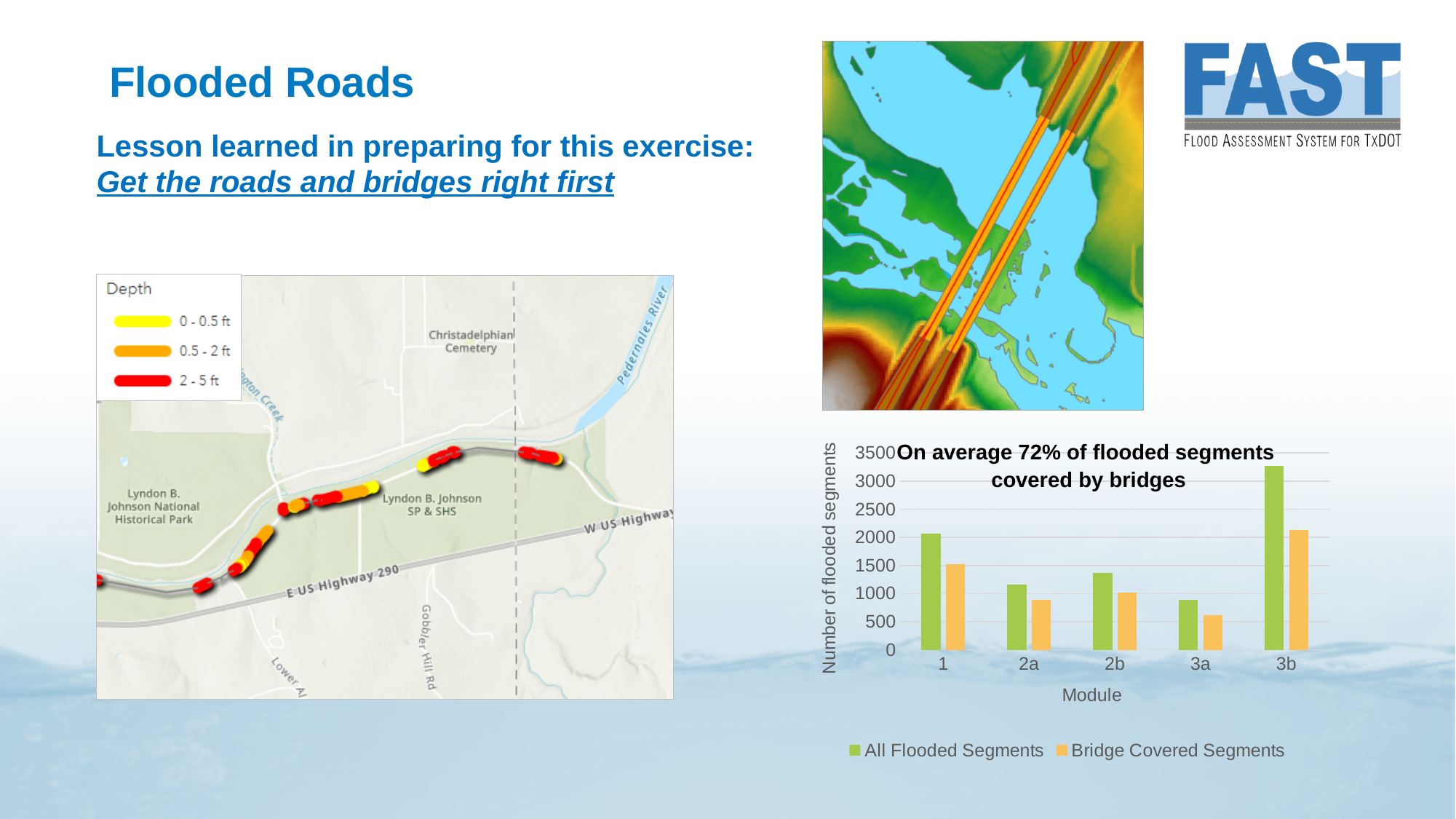
What kind of chart is shown on the slide? bar chart What is the title of the bar chart? On average 72% of flooded segments covered by bridges Is the value for All Flooded Segments in module 3a greater or less than 1000? less How many modules are shown on the x axis of the bar chart? 5 Is the value for All Flooded Segments in module 3b greater or less than 3000? greater Which module has the highest number of All Flooded Segments? 3b Is the value for Bridge Covered Segments in module 1 greater or less than 1000? greater What is the label of the y axis of the bar chart? Number of flooded segments Which module has the lowest number of Bridge Covered Segments? 3a How many series does the legend of the bar chart list? 2 Which is larger, All Flooded Segments in module 2a or in module 2b? 2b